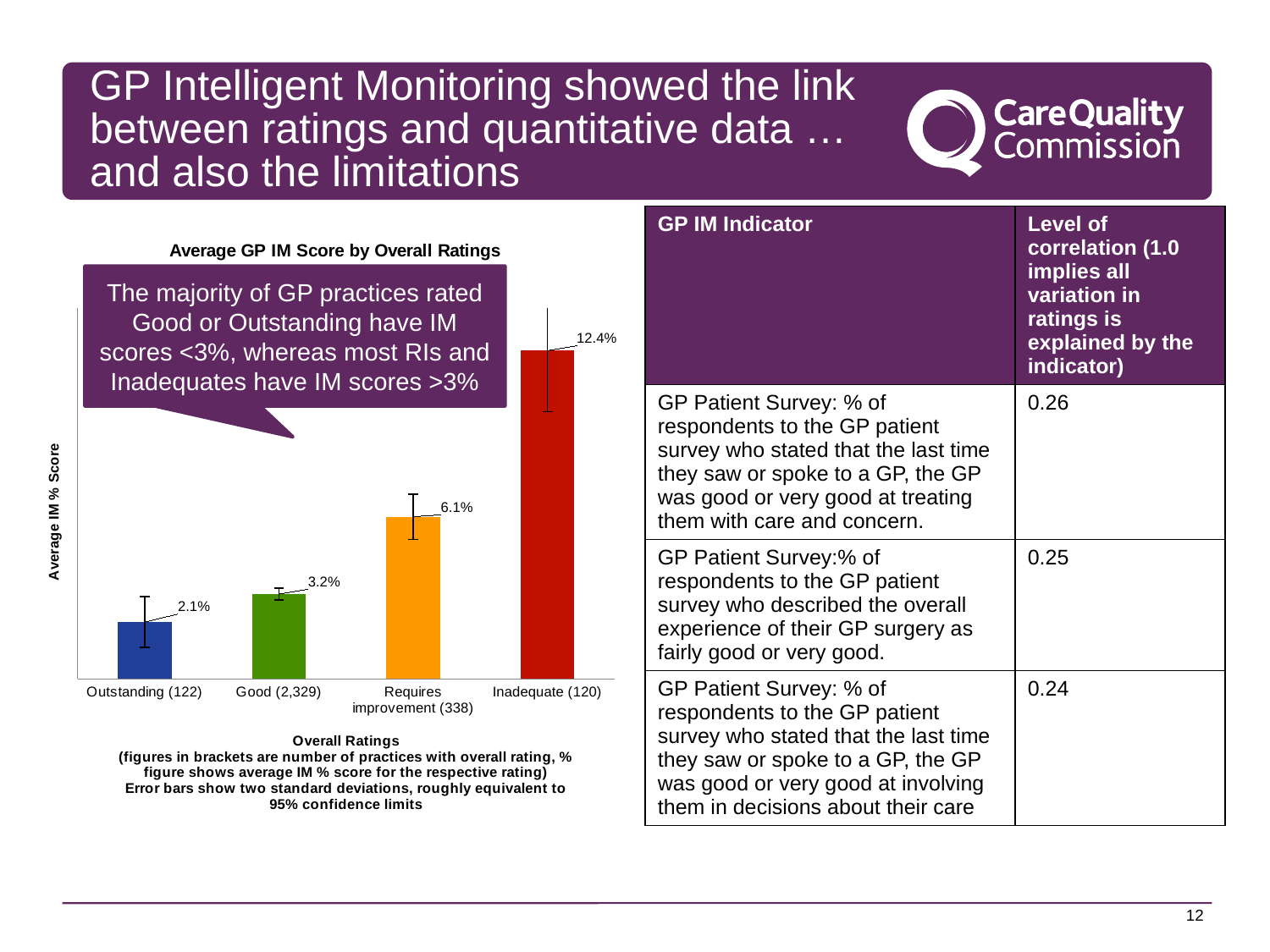
What type of chart is used to show Average GP IM Score by Overall Ratings? Bar chart What is the difference between the average IM % score for Inadequate (120) and Requires improvement (338)? 6.3% What is the average IM % score for Outstanding (122) in the Average GP IM Score by Overall Ratings chart? 2.1% Which has a higher average IM % score, Good (2,329) or Requires improvement (338)? Requires improvement (338) Do the average IM % scores rise or fall moving from Outstanding to Inadequate along the x axis? Rise What is the average IM % score for Inadequate (120)? 12.4% Which overall rating has the highest average IM % score? Inadequate (120) How many overall rating categories are shown in the chart? 4 Which overall rating has the lowest average IM % score? Outstanding (122) What is the average IM % score for Requires improvement (338)? 6.1% What is the difference between the average IM % score for Good (2,329) and Outstanding (122)? 1.1% What is the average IM % score for Good (2,329)? 3.2%